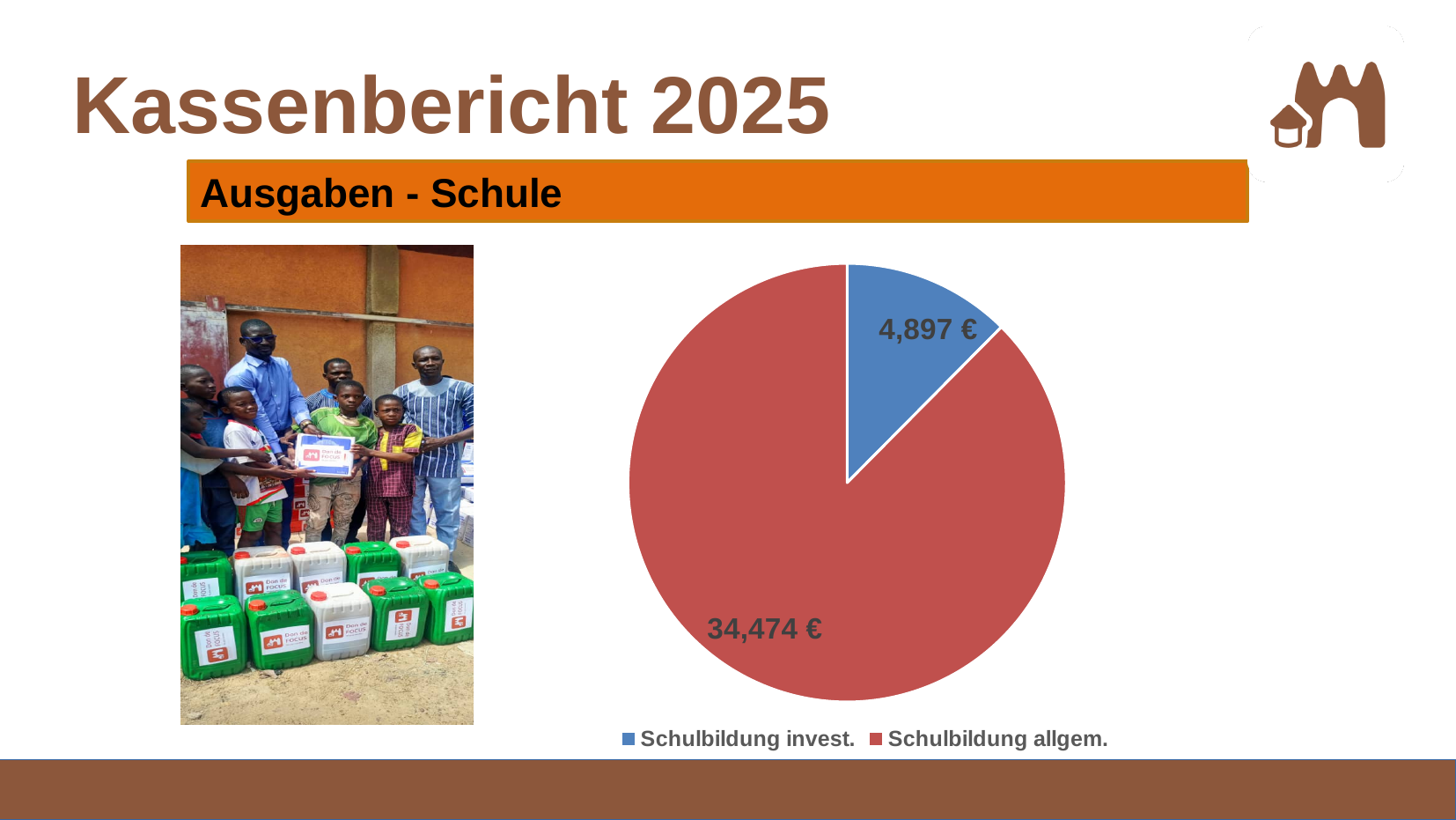
What is the value for Schulbildung allgem.? 34,474 € How many entries does the legend list? 2 What is the value for Schulbildung invest.? 4,897 € What colour is the slice for Schulbildung allgem.? red What is the difference between Schulbildung allgem. and Schulbildung invest.? 29,577 € Which is larger, Schulbildung invest. or Schulbildung allgem.? Schulbildung allgem. What is the total of all slices in the pie chart? 39,371 € How many slices does the pie chart have? 2 What share of the pie does Schulbildung invest. represent, to one decimal place? 12.4% Which category has the smallest slice of the pie? Schulbildung invest. What kind of chart is shown on the slide? pie chart Which category has the largest slice of the pie? Schulbildung allgem.